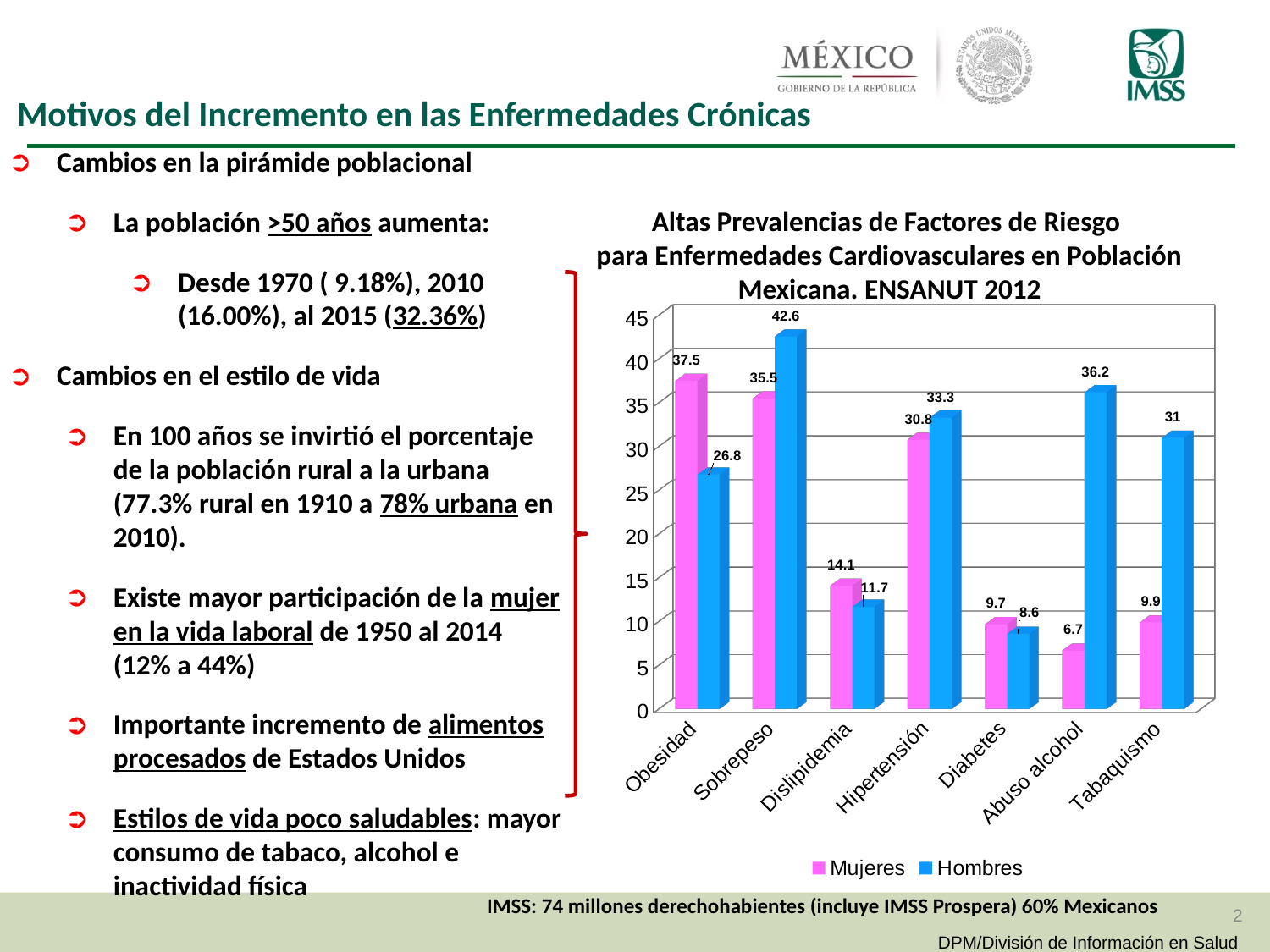
What is the value for Mujeres in the Obesidad category? 37.5 Which colour represents the Mujeres series? Pink Which category has the lowest value for Mujeres? Abuso alcohol What is the value for Mujeres in the Tabaquismo category? 9.9 What kind of chart is shown on the slide? Bar chart How many categories are shown on the x axis? 7 What is the difference between the Hombres and Mujeres values for Abuso alcohol? 29.5 What is the value for Hombres in the Abuso alcohol category? 36.2 What is the value for Hombres in the Sobrepeso category? 42.6 Which category has the highest value for Hombres? Sobrepeso Which is larger for Hipertensión, the Mujeres value or the Hombres value? Hombres How many series does the legend list? 2